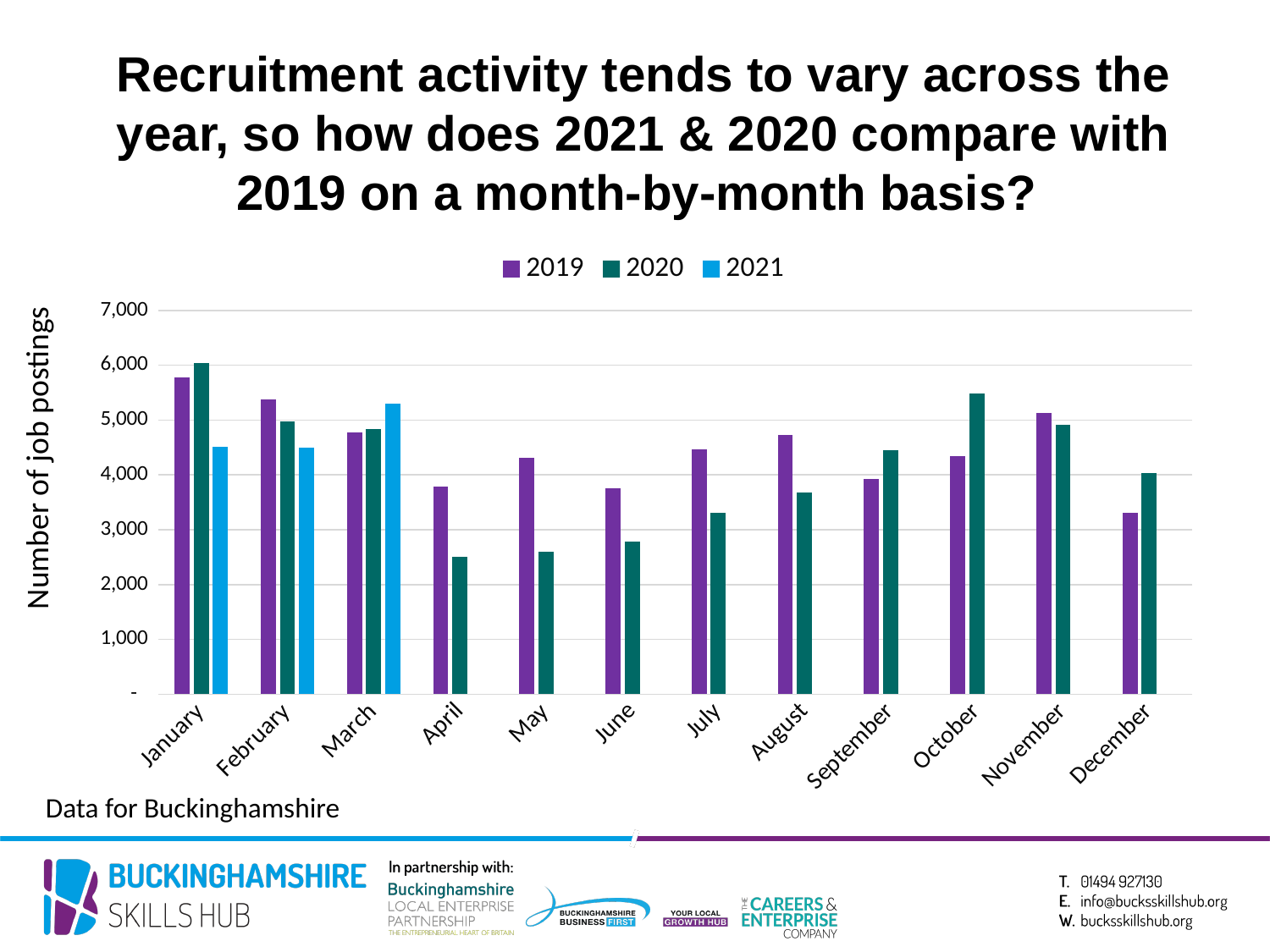
In which month is the 2020 value highest? January Is the value for October 2020 greater or less than 5,000? greater In April, which year has the larger number of job postings, 2019 or 2020? 2019 Is the value for May 2020 greater or less than 3,000? less In October, which year has the larger number of job postings, 2019 or 2020? 2020 How many series does the legend list? 3 In which month is the 2020 value lowest? April Do the 2020 values rise or fall from April to October? rise In March, which year has the larger number of job postings, 2019 or 2021? 2021 In which month is the 2019 value highest? January How many months are shown along the x axis? 12 What kind of chart is shown on the slide? Bar chart